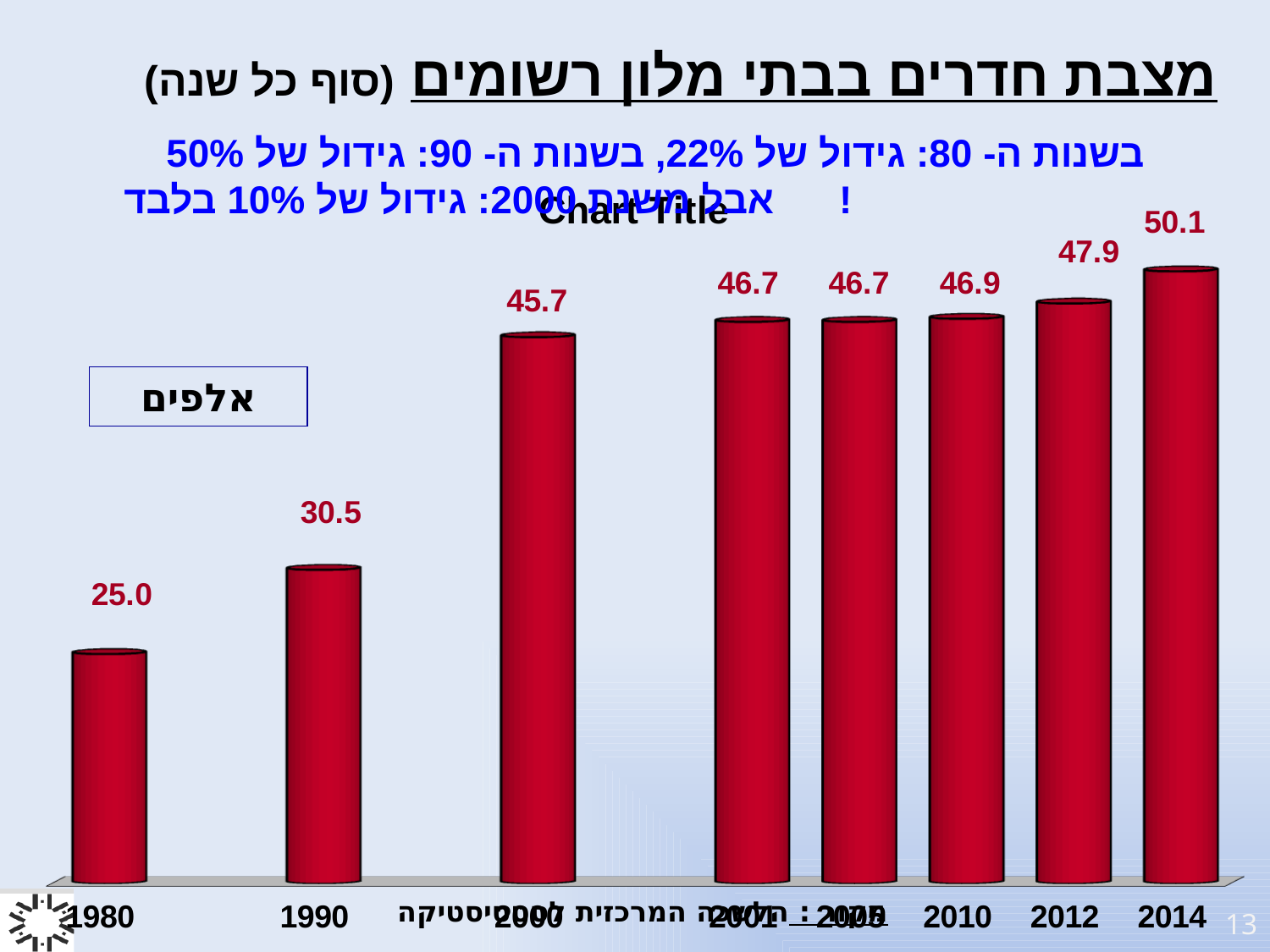
What is the difference between the values for 2014 and 1980? 25.1 Which is larger, the value for 1990 or the value for 2000? 2000 What kind of chart is shown? bar chart What is the value for 2012? 47.9 What is the value for 2014? 50.1 What is the value for 1980? 25.0 What is the value for 2010? 46.9 Which year has the highest value? 2014 What is the value for 1990? 30.5 What is the value for 2000? 45.7 How many bars are in the chart? 8 Which year has the lowest value? 1980